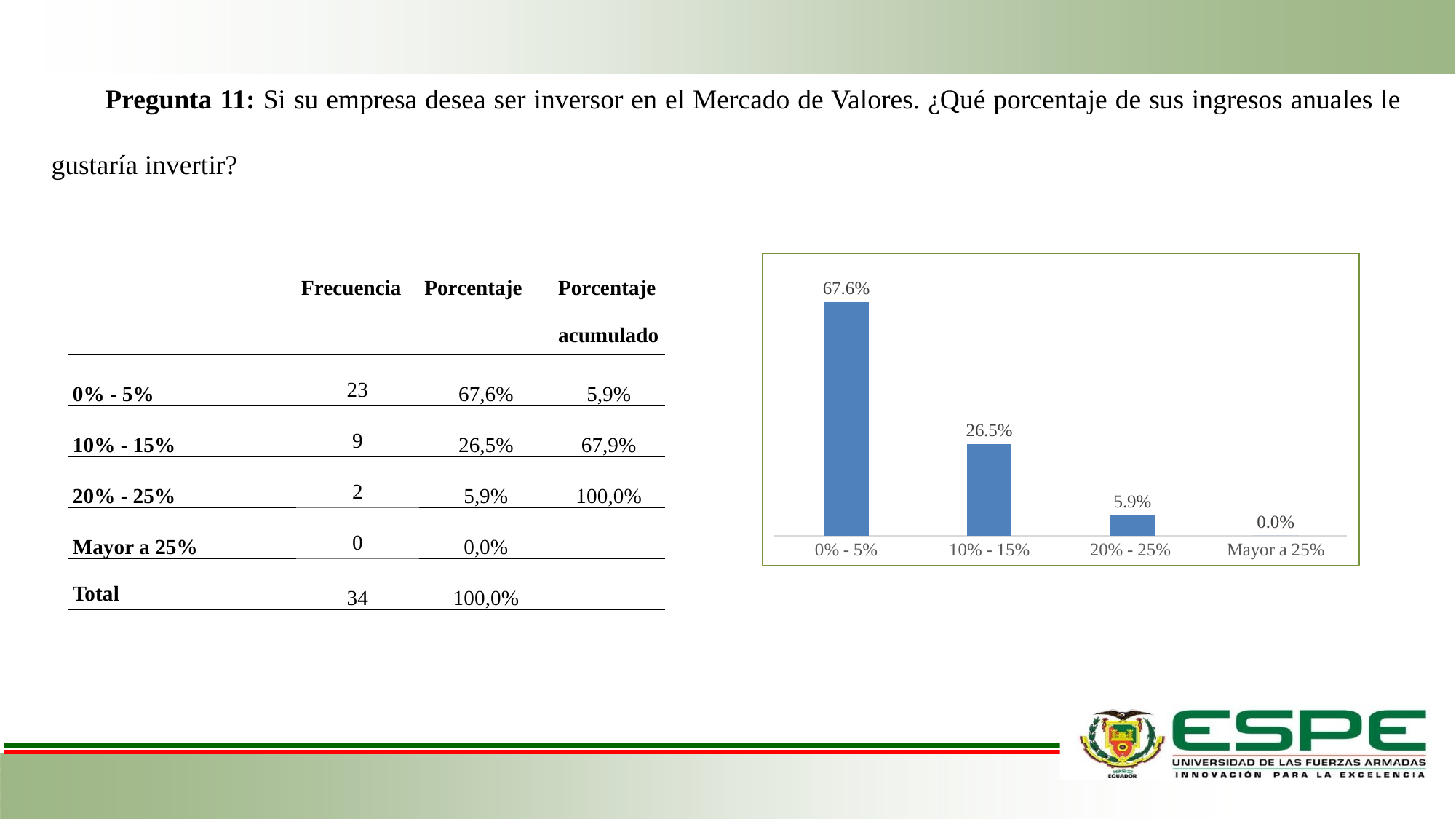
What is the difference between the values for 0% - 5% and 10% - 15% in the bar chart? 41.1% What is the value shown for the 20% - 25% category in the bar chart? 5.9% How many categories are shown on the x axis of the bar chart? 4 What kind of chart is shown on the slide? bar chart Which is larger in the bar chart, the value for 10% - 15% or the value for 20% - 25%? 10% - 15% What is the value shown for the Mayor a 25% category in the bar chart? 0.0% What is the value shown for the 10% - 15% category in the bar chart? 26.5% What is the difference between the values for 10% - 15% and 20% - 25% in the bar chart? 20.6% What is the value shown for the 0% - 5% category in the bar chart? 67.6% Do the values in the bar chart rise or fall from left to right along the x axis? fall Which category has the highest value in the bar chart? 0% - 5% Which category has the lowest value in the bar chart? Mayor a 25%